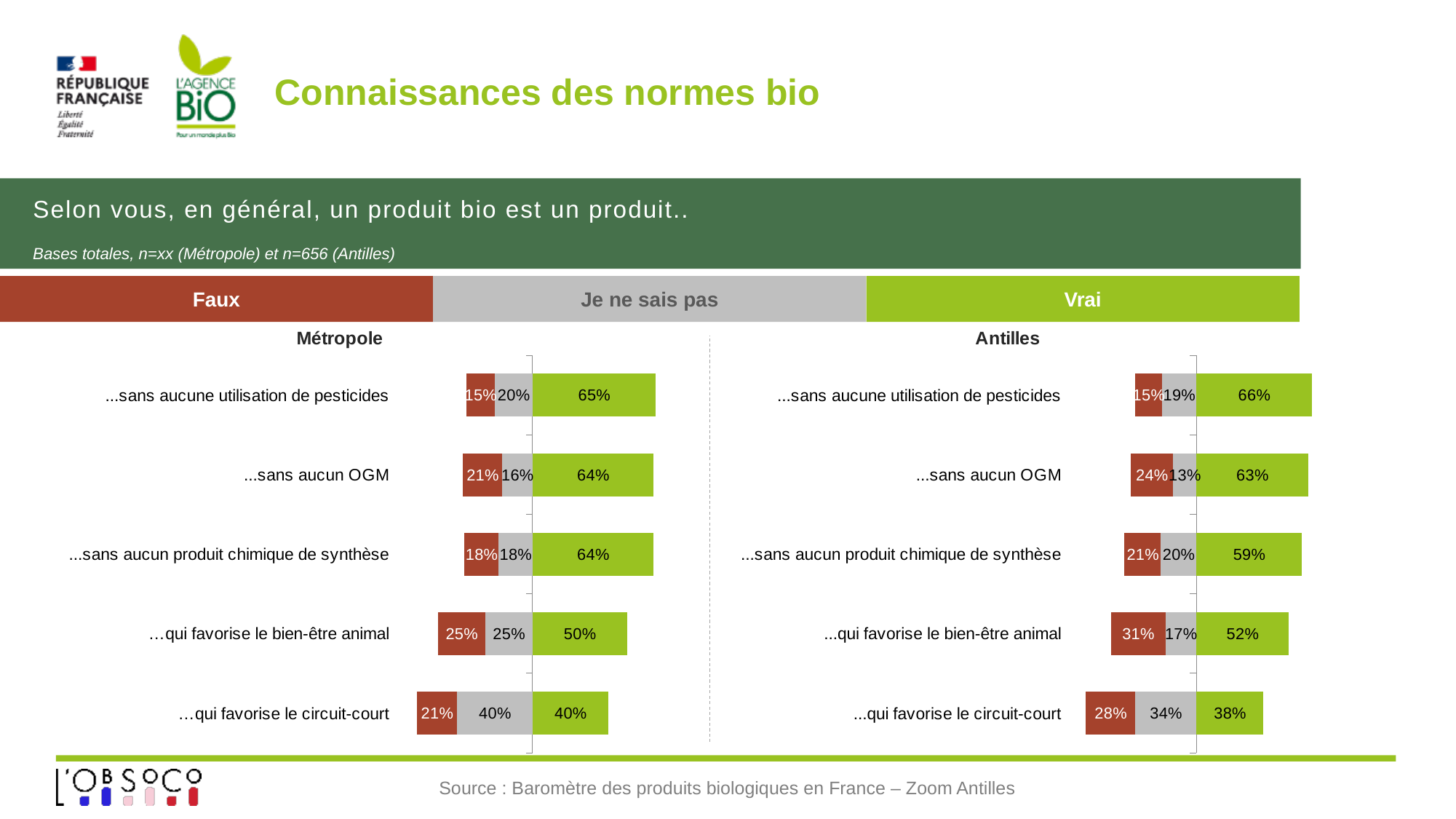
What kind of chart is used for the Métropole data? Stacked bar chart Which colour represents the 'Vrai' series in the legend? Green In the Antilles chart, what is the 'Je ne sais pas' value for '...qui favorise le circuit-court'? 34% How many categories are shown in the Antilles chart? 5 In the Antilles chart, what is the 'Faux' value for '...qui favorise le bien-être animal'? 31% In the Métropole chart, what is the difference between the 'Je ne sais pas' value for '...qui favorise le circuit-court' and for '...sans aucun OGM'? 24% In the Antilles chart, which category has the lowest 'Vrai' value? ...qui favorise le circuit-court How many series does the legend list? 3 In the Antilles chart, what is the total of the 'Faux' and 'Je ne sais pas' values for '...sans aucun produit chimique de synthèse'? 41% Which is larger: the 'Faux' value for '...sans aucun OGM' in the Antilles chart or in the Métropole chart? Antilles In the Métropole chart, what is the 'Vrai' value for '...sans aucune utilisation de pesticides'? 65% In the Métropole chart, which category has the highest 'Vrai' value? ...sans aucune utilisation de pesticides